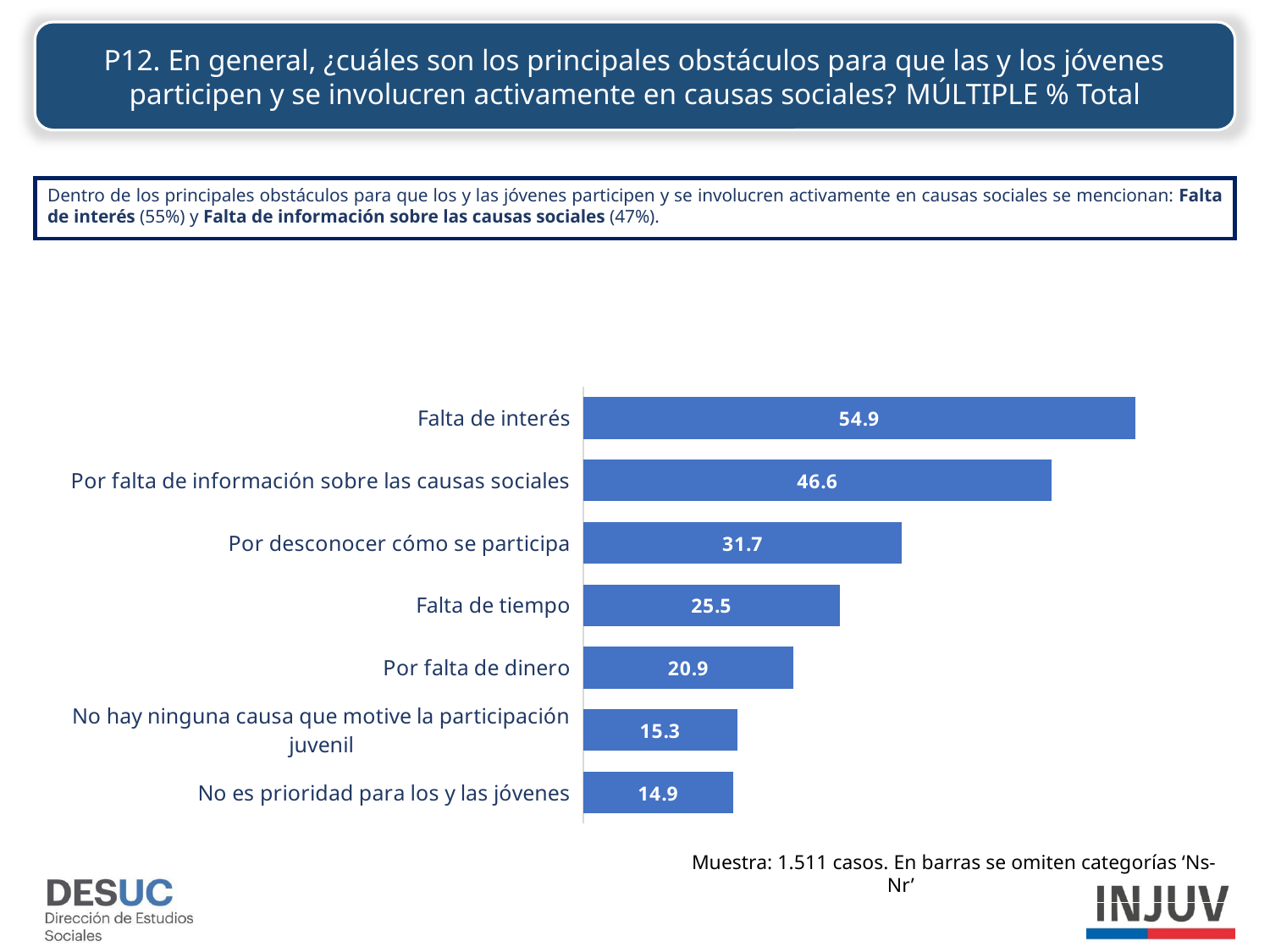
Which category has the lowest value? No es prioridad para los y las jóvenes What colour are the bars in the chart? Blue What is the difference between the values for "Falta de interés" and "Por falta de información sobre las causas sociales"? 8.3 What is the value for "Por desconocer cómo se participa"? 31.7 What kind of chart is shown on the slide? Bar chart What is the difference between the values for "Falta de tiempo" and "Por falta de dinero"? 4.6 What is the value for "Falta de interés"? 54.9 Which is larger: the value for "Falta de tiempo" or the value for "No hay ninguna causa que motive la participación juvenil"? Falta de tiempo What is the value for "No es prioridad para los y las jóvenes"? 14.9 Which category has the highest value? Falta de interés How many categories are shown in the chart? 7 What is the value for "Por falta de dinero"? 20.9